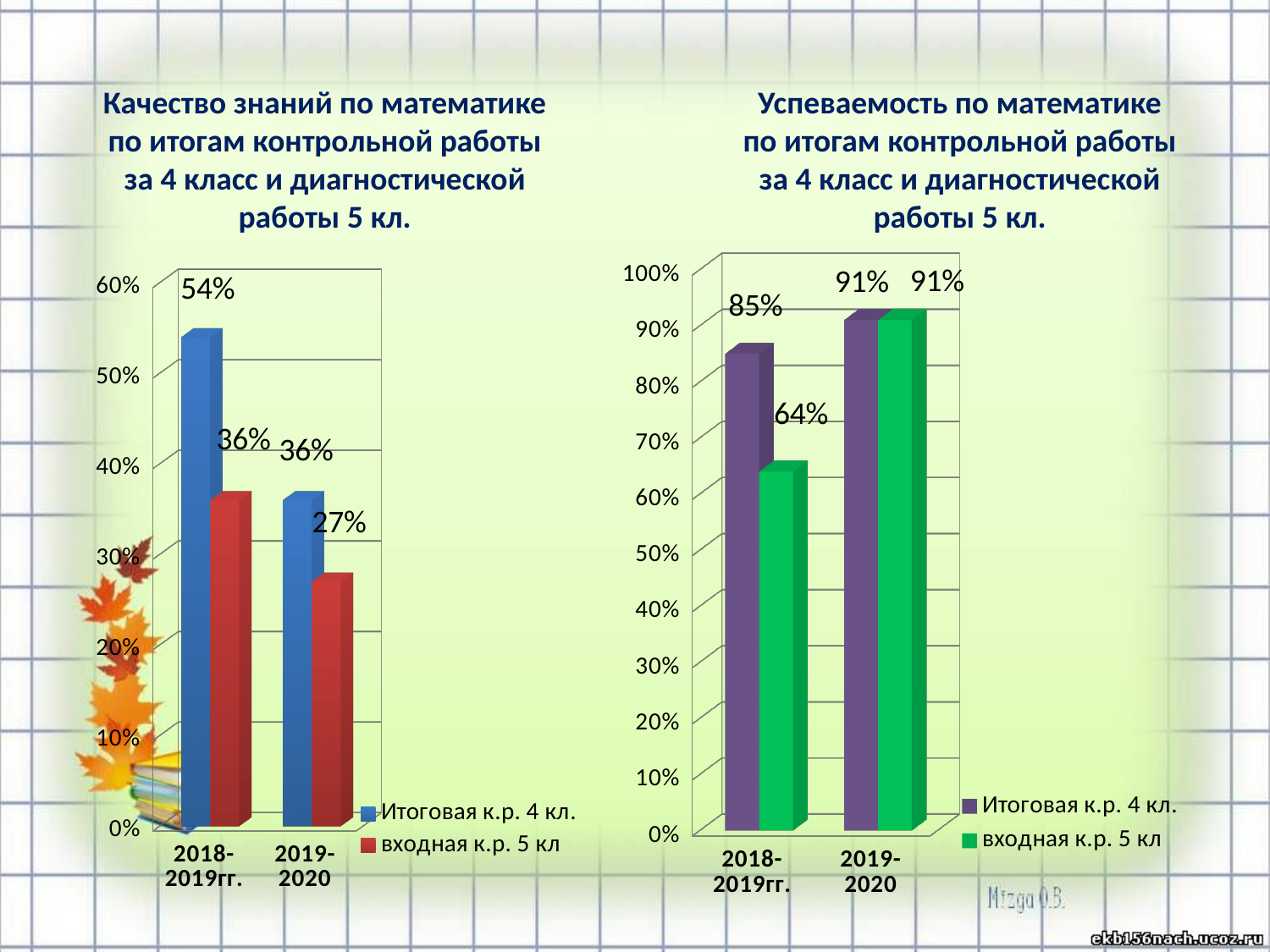
In the left chart (Качество знаний по математике), what is the value for Итоговая к.р. 4 кл. in 2018-2019гг.? 54% In the right chart (Успеваемость по математике), what is the difference between Итоговая к.р. 4 кл. and входная к.р. 5 кл in 2018-2019гг.? 21% In the right chart (Успеваемость по математике), which bar has the lowest value? входная к.р. 5 кл in 2018-2019гг. How many series does the legend of the left chart (Качество знаний по математике) list? 2 In the left chart (Качество знаний по математике), which is larger: входная к.р. 5 кл in 2018-2019гг. or входная к.р. 5 кл in 2019-2020? входная к.р. 5 кл in 2018-2019гг. What type of chart is the right chart (Успеваемость по математике)? Bar chart In the left chart (Качество знаний по математике), what is the value for входная к.р. 5 кл in 2019-2020? 27% In the right chart (Успеваемость по математике), what is the value for Итоговая к.р. 4 кл. in 2019-2020? 91% How does the value for Итоговая к.р. 4 кл. change from 2018-2019гг. to 2019-2020 in the right chart (Успеваемость по математике)? It rises In the right chart (Успеваемость по математике), what is the value for входная к.р. 5 кл in 2018-2019гг.? 64% In the left chart (Качество знаний по математике), what is the difference between Итоговая к.р. 4 кл. and входная к.р. 5 кл in 2018-2019гг.? 18% In the left chart (Качество знаний по математике), which bar has the highest value? Итоговая к.р. 4 кл. in 2018-2019гг.